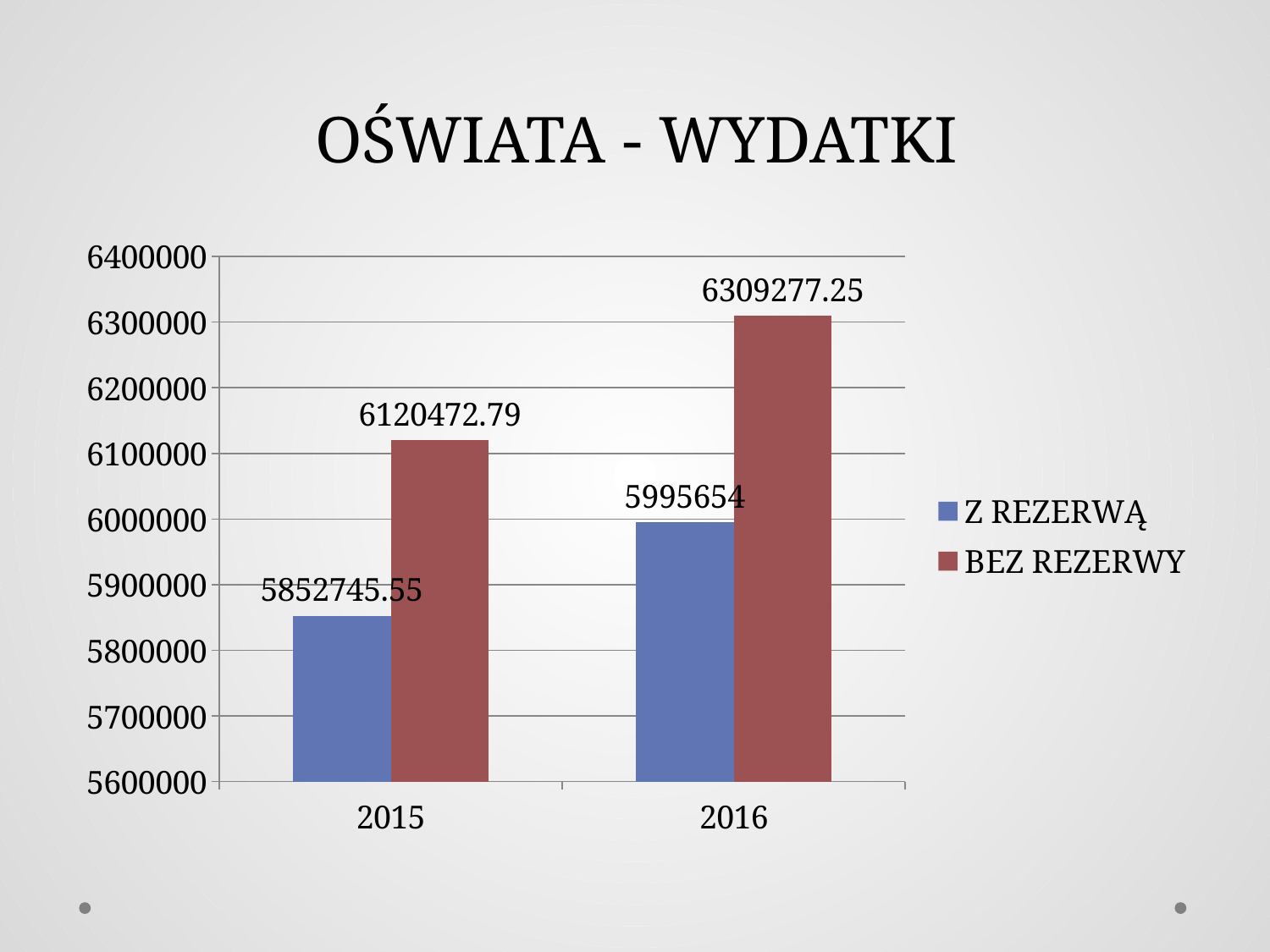
How many series does the legend list? 2 What is the value for BEZ REZERWY in 2015? 6120472.79 Which bar has the lowest value on the chart? Z REZERWĄ in 2015 What is the value for Z REZERWĄ in 2016? 5995654 What is the difference between BEZ REZERWY and Z REZERWĄ in 2016? 313623.25 What is the value for BEZ REZERWY in 2016? 6309277.25 What is the value for Z REZERWĄ in 2015? 5852745.55 Which bar has the highest value on the chart? BEZ REZERWY in 2016 Which is larger: Z REZERWĄ in 2016 or BEZ REZERWY in 2015? BEZ REZERWY in 2015 Do the Z REZERWĄ values rise or fall from 2015 to 2016? Rise What kind of chart is shown on the slide? Bar chart What is the difference between BEZ REZERWY and Z REZERWĄ in 2015? 267727.24